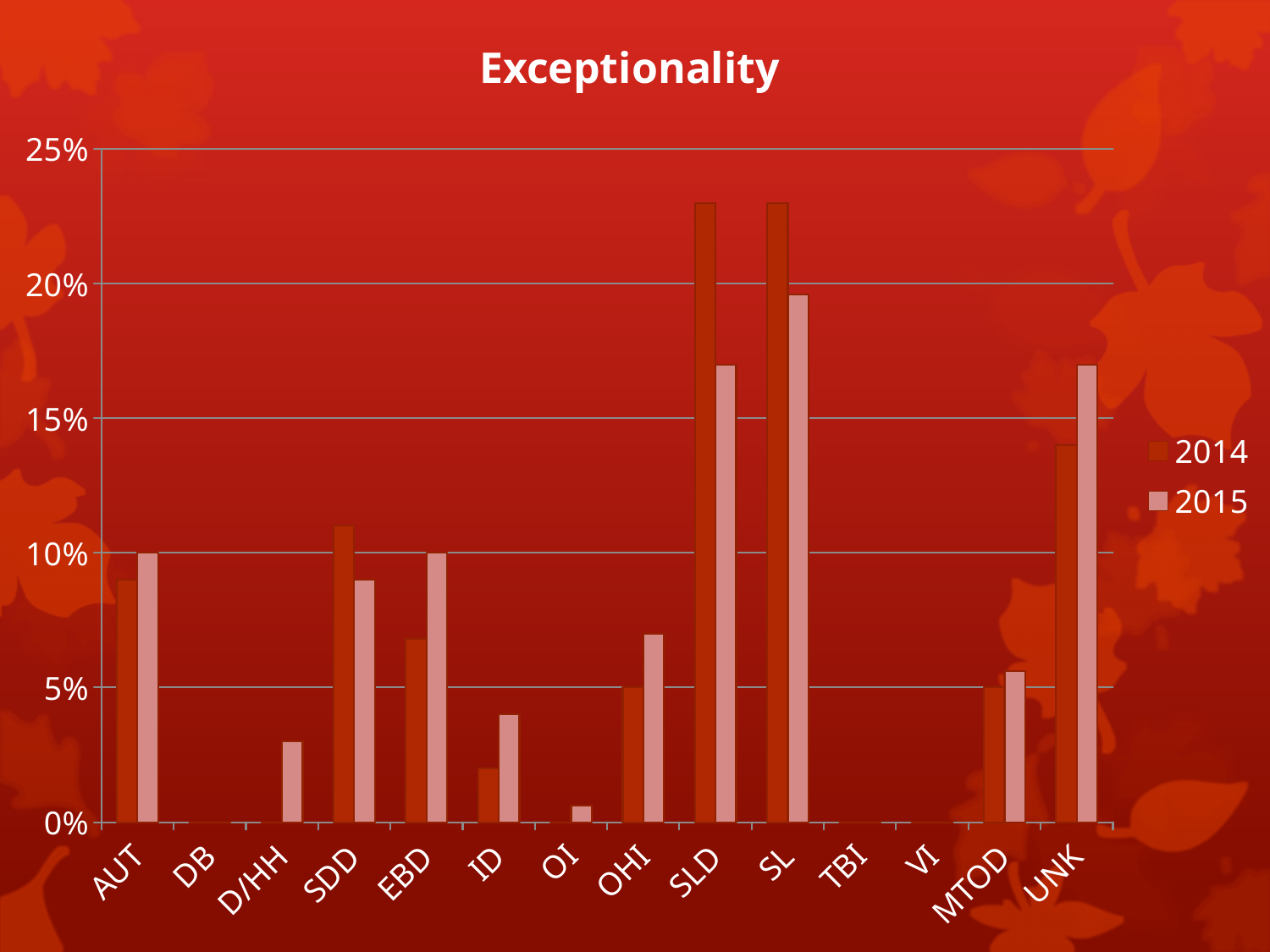
For SDD, which year has the larger value, 2014 or 2015? 2014 Is the 2015 value for UNK greater or less than 15%? greater How many series does the legend list? 2 What kind of chart is shown on the slide? bar chart Is the 2014 value for SLD greater or less than 20%? greater Is the 2015 value for ID greater or less than 5%? less Which two series are listed in the legend? 2014 and 2015 For UNK, which year has the larger value, 2014 or 2015? 2015 How many categories are shown on the x axis? 14 What is the title of the chart? Exceptionality For 2015, which is larger: SL or SLD? SL